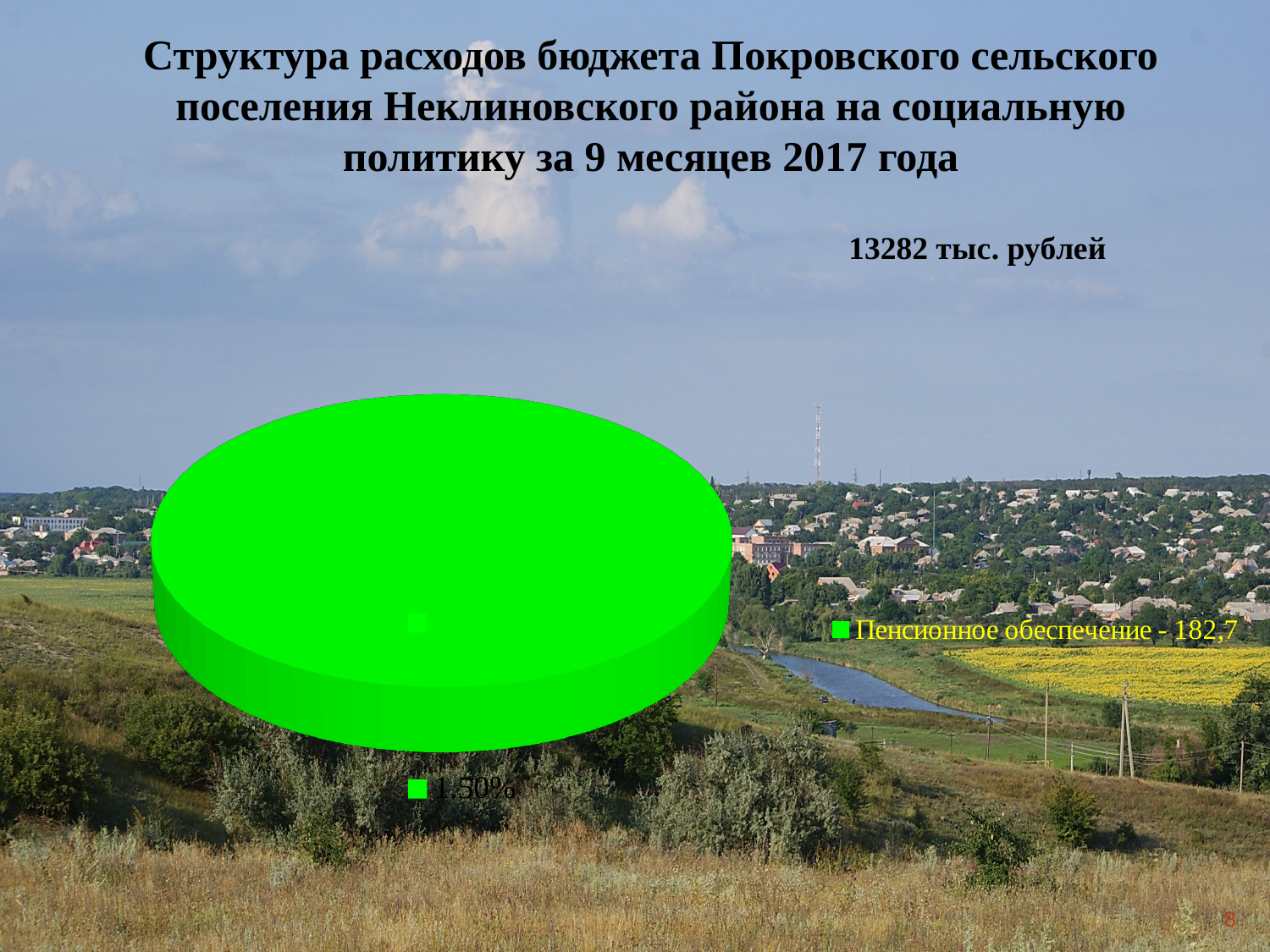
What value is shown in the legend for Пенсионное обеспечение? 182,7 How many slices does the pie chart have? 1 How many entries does the chart legend list? 1 What category is listed in the chart legend? Пенсионное обеспечение What kind of chart is shown on the slide? pie chart What colour is the pie slice for Пенсионное обеспечение? green What percentage label is printed on the pie chart? 1,50% What total amount in thousand rubles is printed on the slide above the chart? 13282 тыс. рублей